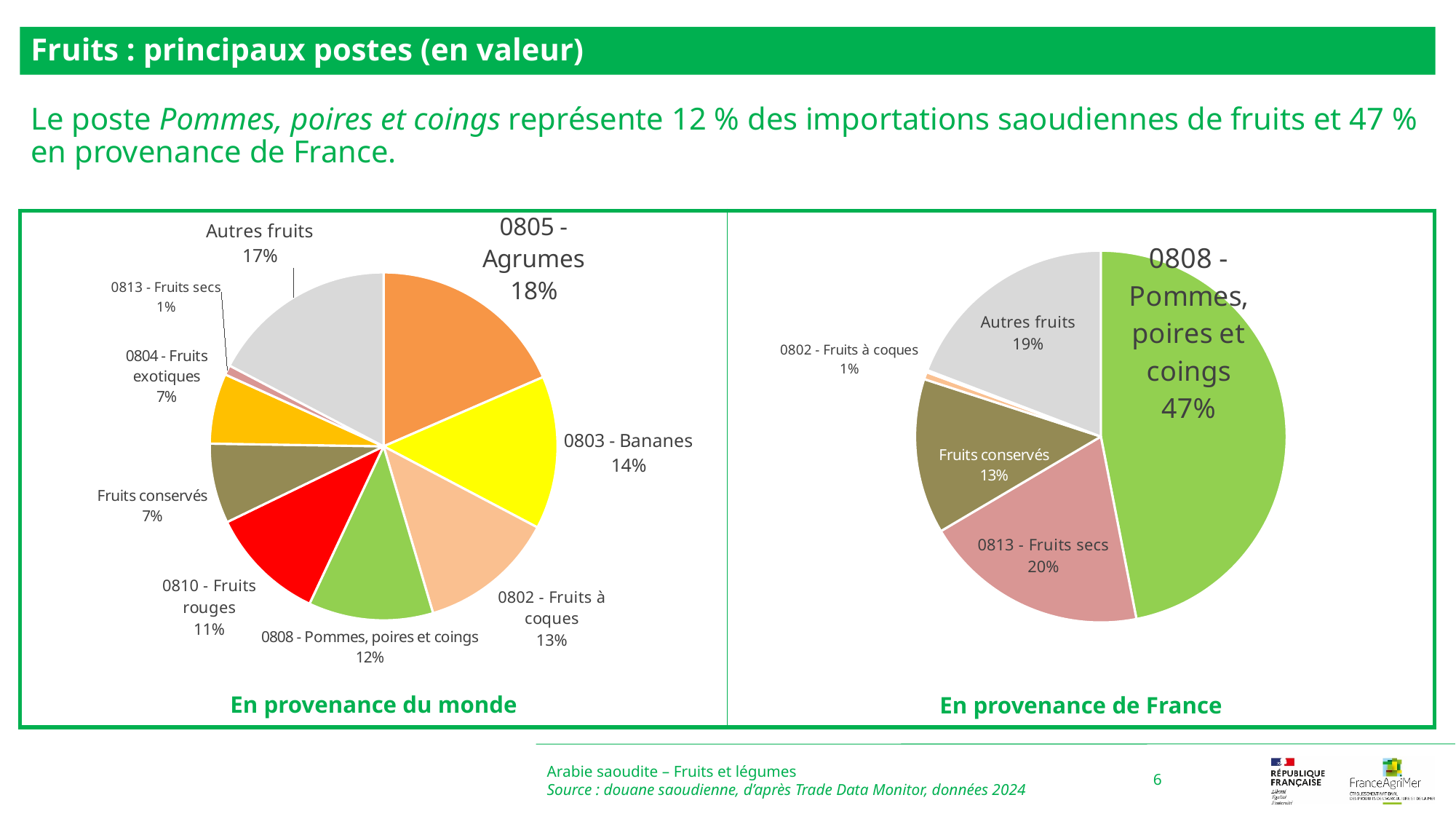
What is the difference between the share of 0808 - Pommes, poires et coings in the 'En provenance de France' chart and in the 'En provenance du monde' chart? 35 percentage points In the 'En provenance du monde' pie chart, which is larger: 0802 - Fruits à coques or 0810 - Fruits rouges? 0802 - Fruits à coques In the 'En provenance du monde' pie chart, what share does 0805 - Agrumes represent? 18% How many slices does the 'En provenance du monde' pie chart have? 9 In the 'En provenance de France' pie chart, which category has the largest share? 0808 - Pommes, poires et coings How many slices does the 'En provenance de France' pie chart have? 5 What type of chart is used for 'En provenance de France'? Pie chart In the 'En provenance du monde' pie chart, which category has the largest share? 0805 - Agrumes In the 'En provenance de France' pie chart, what share does 0813 - Fruits secs represent? 20% In the 'En provenance du monde' pie chart, what share does 0803 - Bananes represent? 14% In the 'En provenance de France' pie chart, what share does Autres fruits represent? 19% In the 'En provenance du monde' pie chart, which category has the smallest share? 0813 - Fruits secs